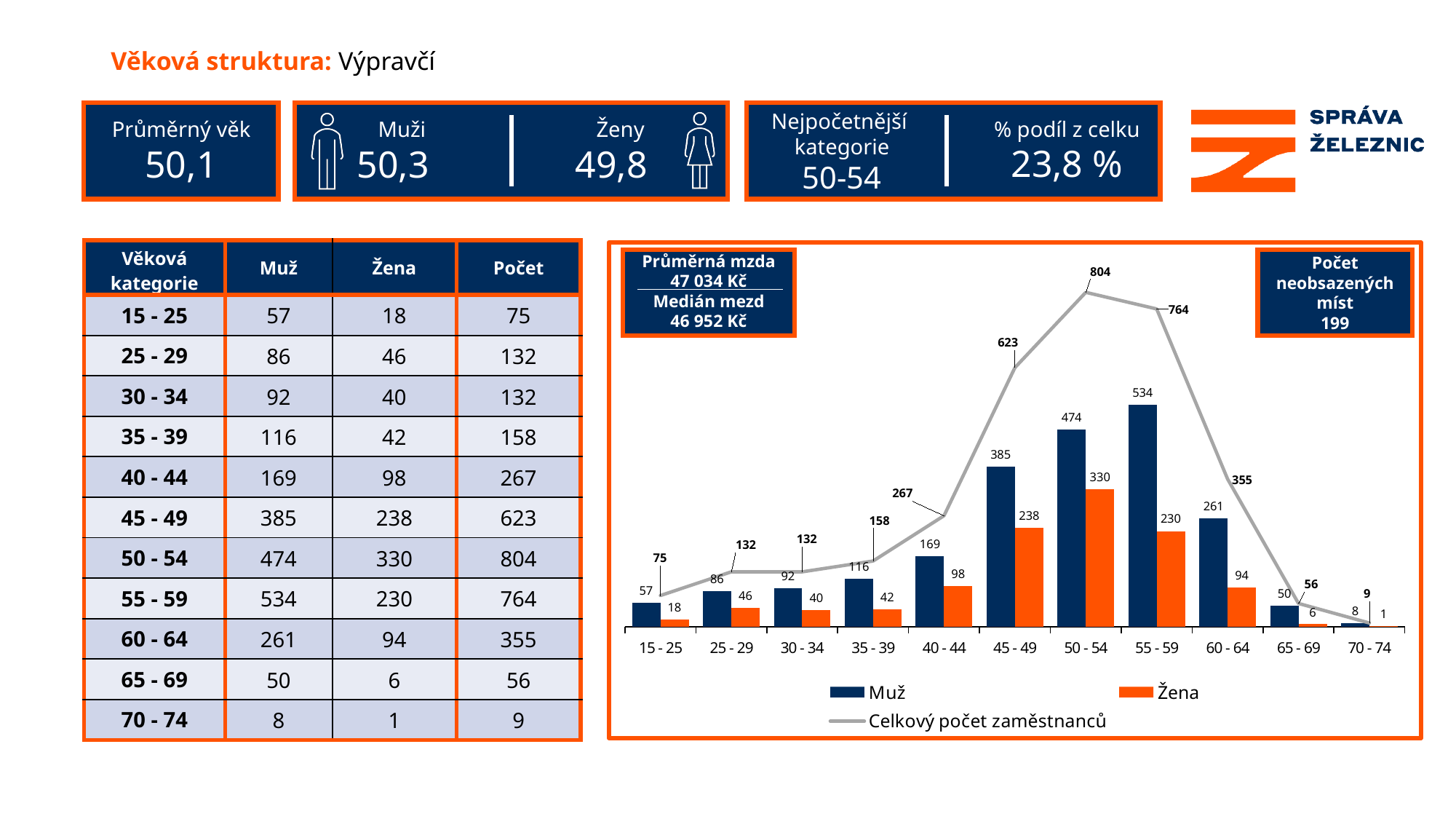
What kind of chart is shown on the slide? Combined bar and line chart How many series does the chart legend list? 3 What is the difference between the Muž and Žena values in the 55 - 59 age category? 304 What is the value for Žena in the 45 - 49 age category? 238 How many age categories are shown on the x axis of the chart? 11 Which age category has the lowest value for Žena? 70 - 74 What is the value of Celkový počet zaměstnanců for the 55 - 59 age category? 764 Which age category has the highest value for Muž? 55 - 59 Which age category has the highest value of Celkový počet zaměstnanců? 50 - 54 Does the Celkový počet zaměstnanců line rise or fall from 55 - 59 to 70 - 74? Fall Which is larger, the Muž value for 45 - 49 or the Muž value for 60 - 64? Muž value for 45 - 49 What is the value for Muž in the 50 - 54 age category? 474